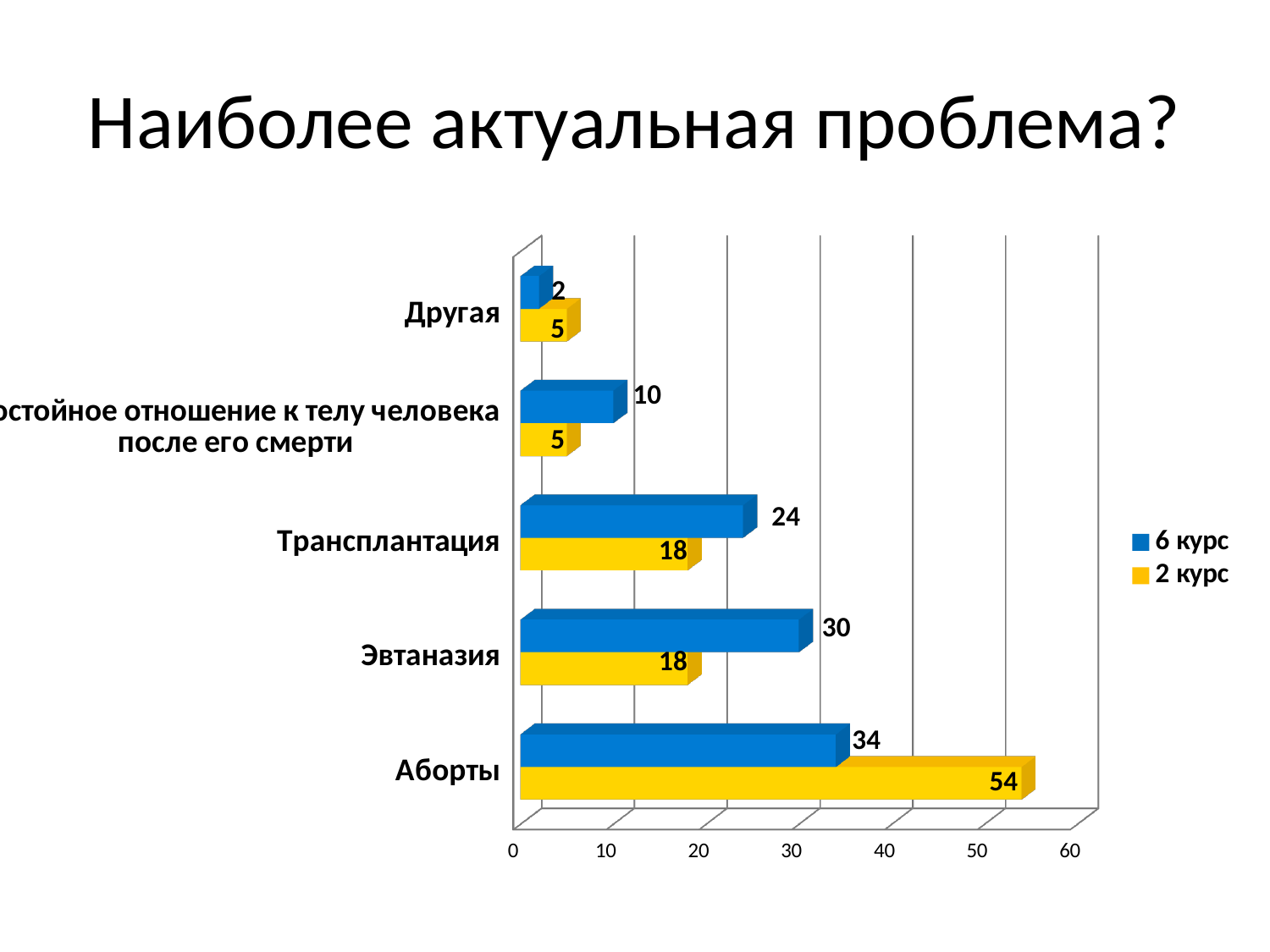
What is the value for Эвтаназия in the 6 курс series? 30 Which category has the lowest value in the 6 курс series? Другая How many series does the legend list? 2 What is the title of the slide? Наиболее актуальная проблема? Which category has the highest value in the 2 курс series? Аборты What type of chart is shown on the slide? bar chart For Трансплантация, which series has the larger value, 6 курс or 2 курс? 6 курс What is the value for Аборты in the 2 курс series? 54 What is the value for Другая in the 6 курс series? 2 What is the difference between the 2 курс and 6 курс values for Аборты? 20 How many categories are shown on the chart? 5 What is the value for Трансплантация in the 2 курс series? 18